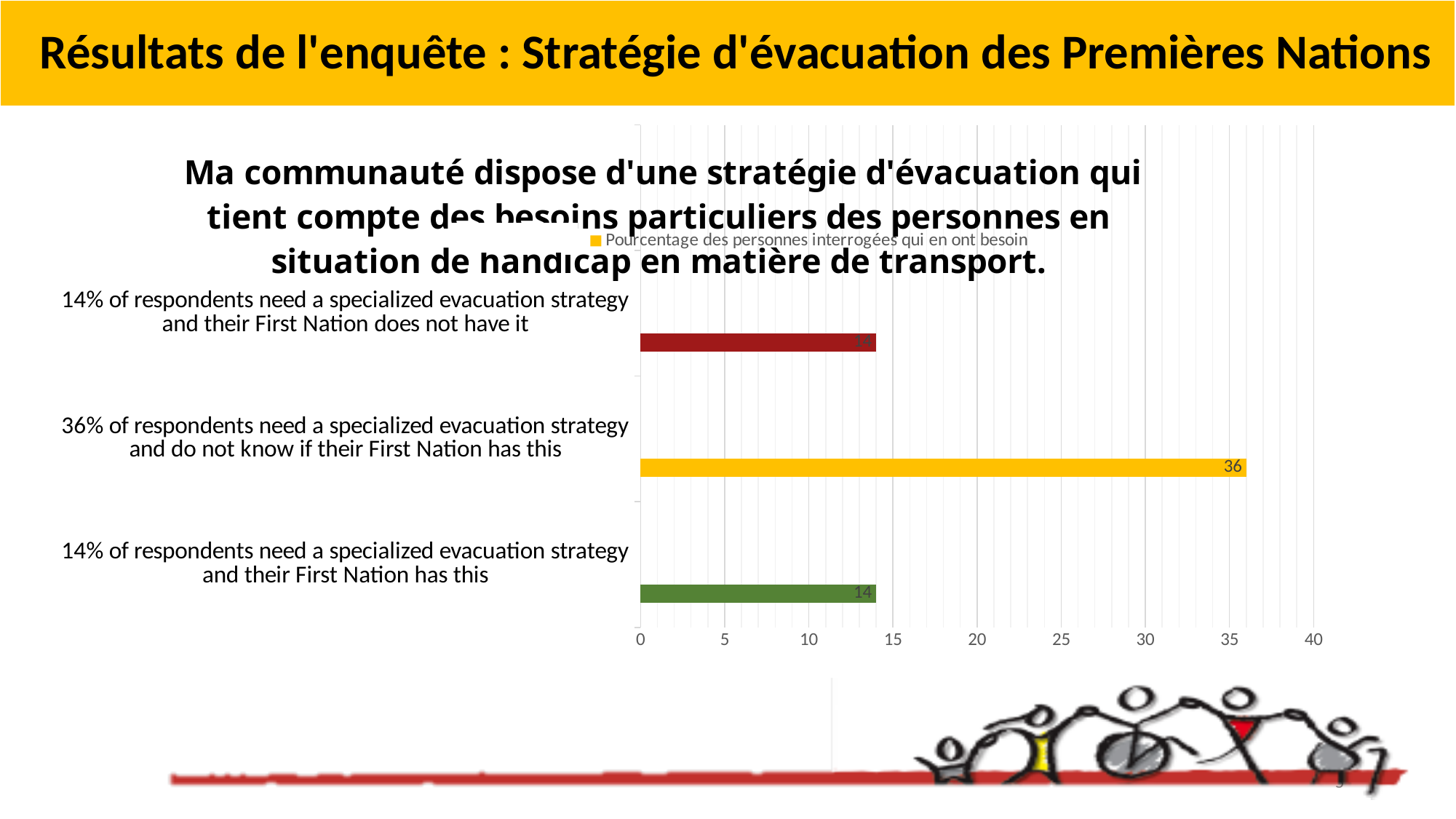
What is the difference between the value for respondents who do not know if their First Nation has this and the value for respondents whose First Nation has this? 22 Which category has the highest value in the chart? 36% of respondents need a specialized evacuation strategy and do not know if their First Nation has this How many categories (bars) are shown in the chart? 3 Is the value for respondents whose First Nation has this greater or less than 20? less How many series does the legend list? 1 What kind of chart is shown on the slide? Bar chart What value is shown for the bar labelled "36% of respondents need a specialized evacuation strategy and do not know if their First Nation has this"? 36 What is the legend entry shown for the chart's series? Pourcentage des personnes interrogées qui en ont besoin Is the value for respondents who do not know if their First Nation has this greater or less than 30? greater Which is larger: the value for respondents who do not know if their First Nation has this, or the value for respondents whose First Nation does not have it? Respondents who do not know if their First Nation has this What value is shown for the bar labelled "14% of respondents need a specialized evacuation strategy and their First Nation has this"? 14 What value is shown for the bar labelled "14% of respondents need a specialized evacuation strategy and their First Nation does not have it"? 14